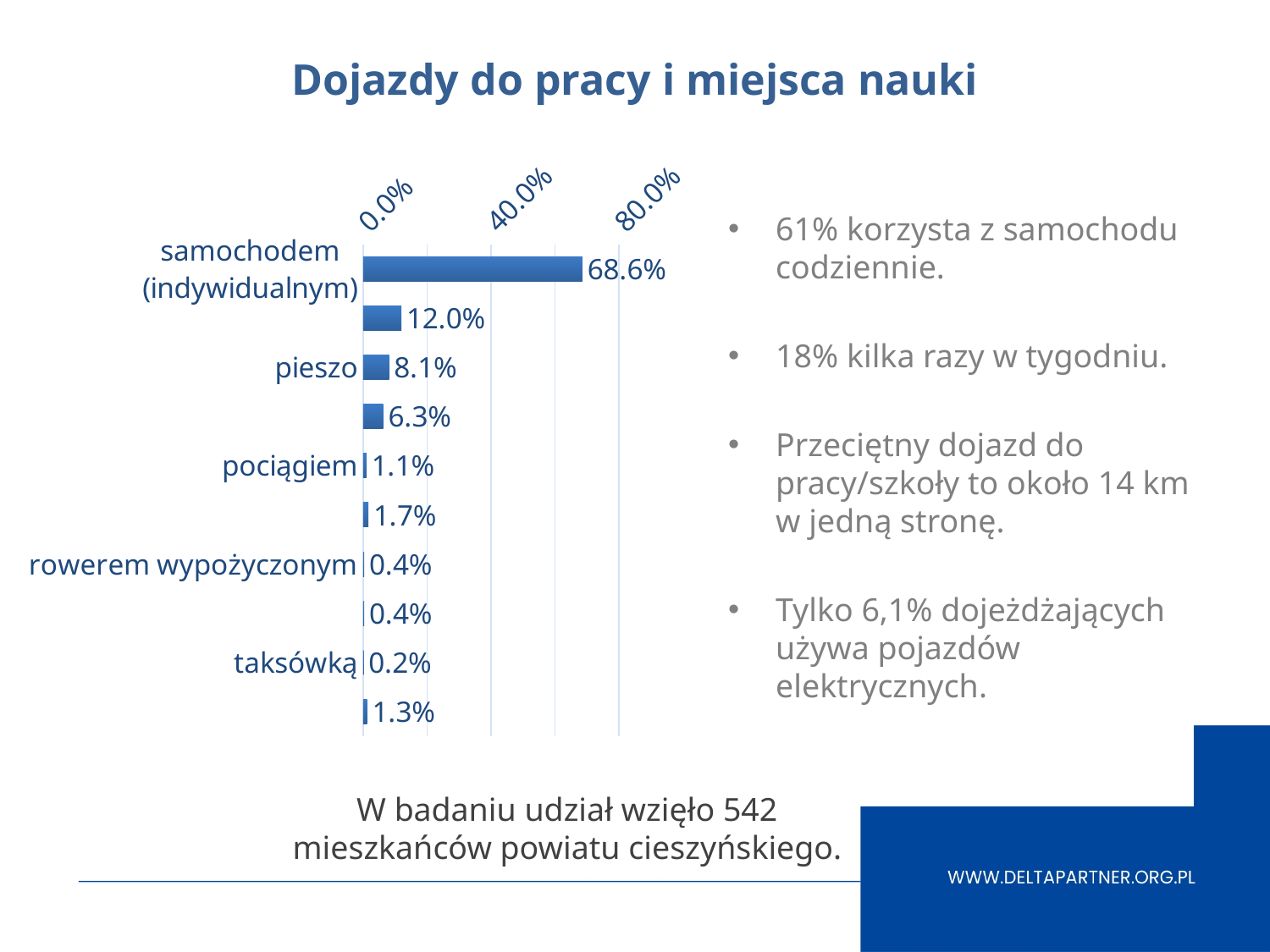
What is the value for taksówką? 0.2% What is the value for samochodem (indywidualnym)? 68.6% What is the difference between the values for samochodem (indywidualnym) and pieszo? 60.5% Which category has the highest value? samochodem (indywidualnym) What is the value for pociągiem? 1.1% How many bars are plotted in the chart? 10 Which is larger, the value for pieszo or the value for pociągiem? pieszo Is the value for samochodem (indywidualnym) greater or less than 40.0%? greater What is the value for pieszo? 8.1% Which category has the lowest value? taksówką What is the value for rowerem wypożyczonym? 0.4% What kind of chart is shown on the slide? bar chart